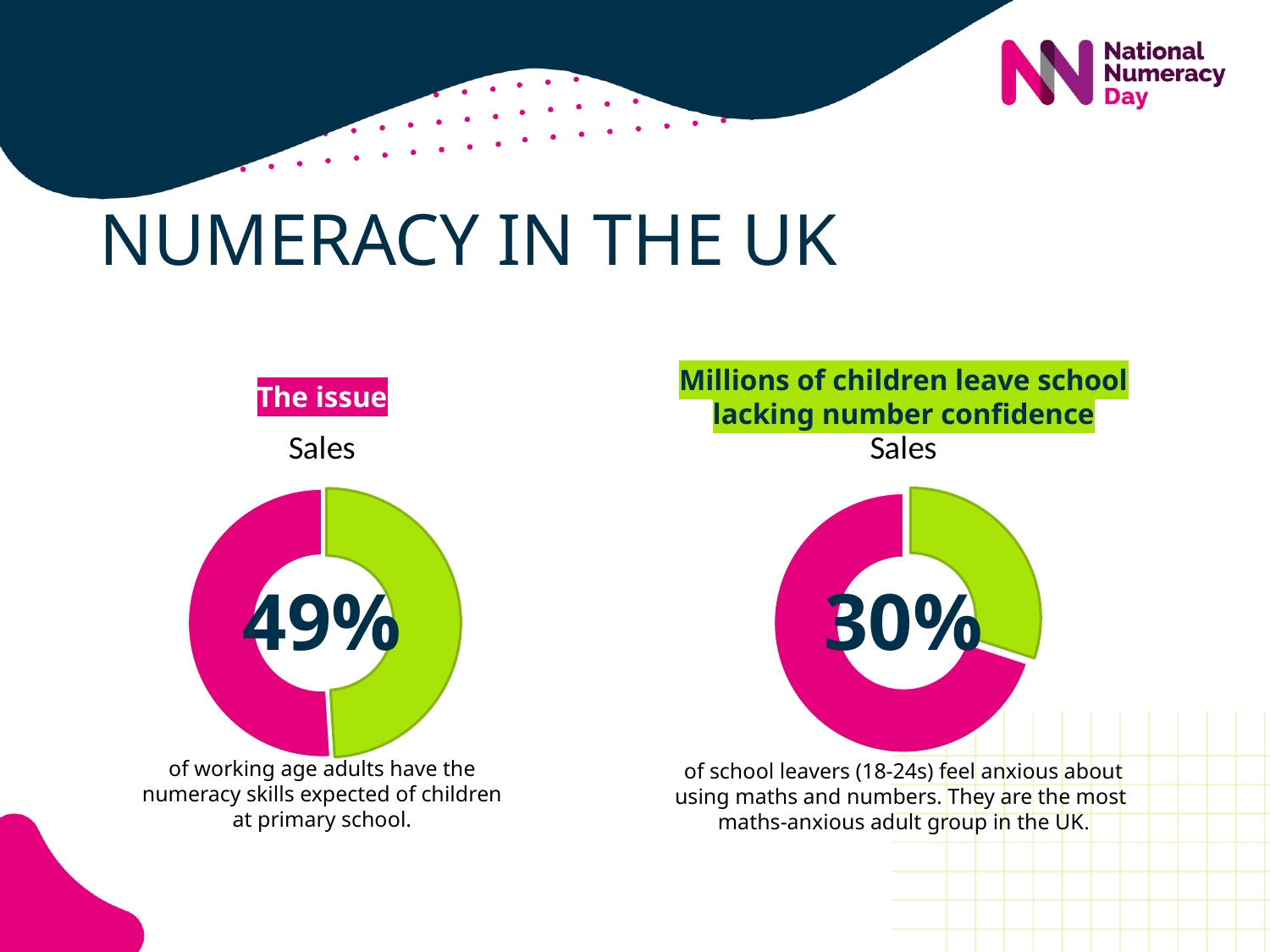
What title is printed directly above each doughnut chart? Sales What percentage is printed in the centre of the right chart under "Millions of children leave school lacking number confidence"? 30% How many slices does the right chart have? 2 What two colours are used for the slices in the left chart? Pink and green In the right chart, is the pink slice greater or less than 50% of the doughnut? greater Is the percentage shown in the right chart greater or less than 50%? less What kind of chart is shown under "The issue" on the left of the slide? Doughnut (pie) chart What is the difference between the percentage in the left chart and the percentage in the right chart? 19% What percentage is printed in the centre of the left chart under "The issue"? 49% How many charts are on the slide? 2 Which chart shows the larger central percentage, the left chart (49%) or the right chart (30%)? The left chart In the right chart, which slice is larger, the pink one or the green one? The pink one